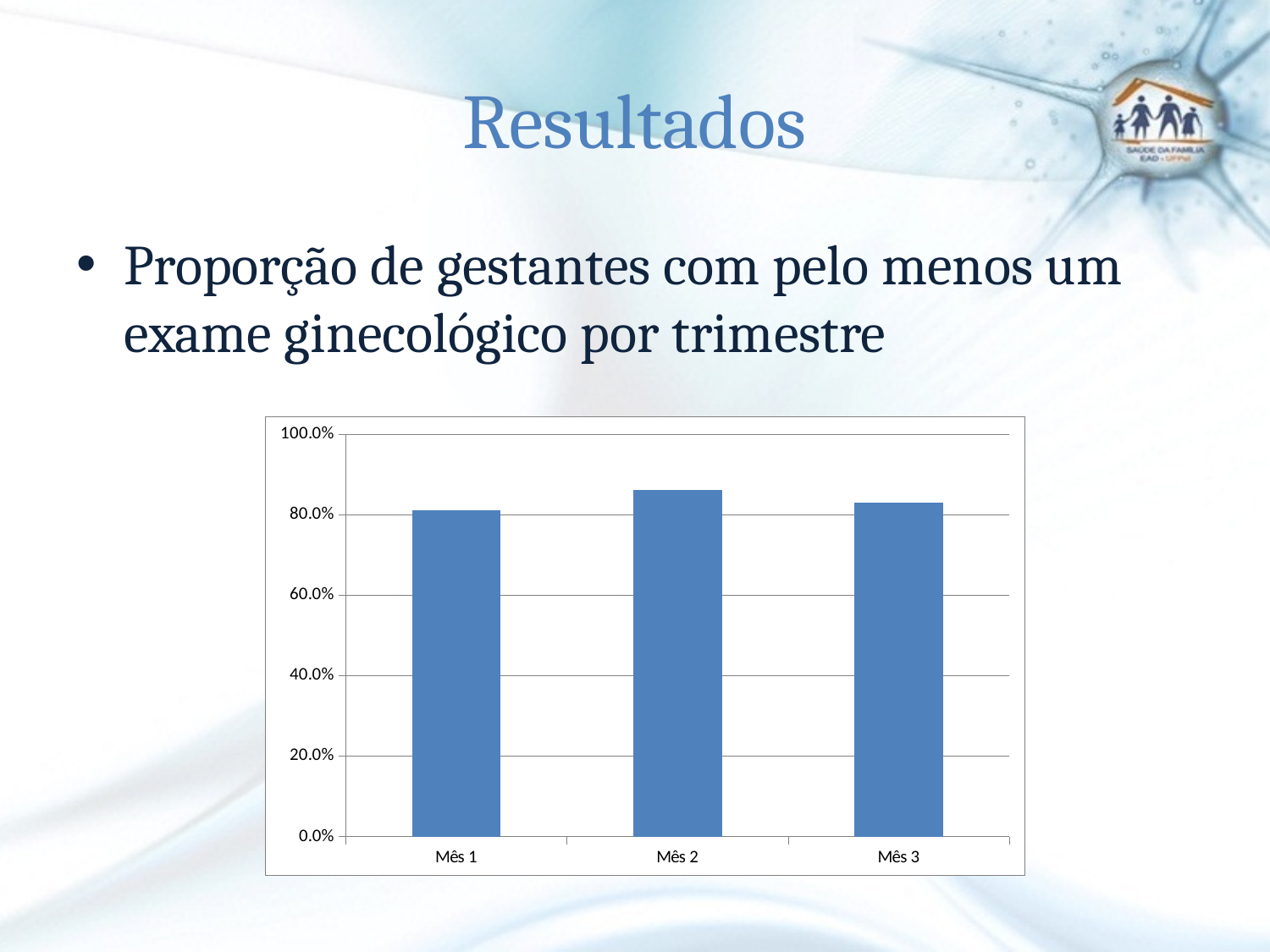
How many categories are shown on the x axis of the chart? 3 Which is larger, the value for Mês 2 or the value for Mês 3? Mês 2 What kind of chart is shown on the slide? bar chart Is the value for Mês 3 greater or less than 80.0%? greater Is the value for Mês 2 greater or less than 80.0%? greater Is the value for Mês 2 greater or less than 100.0%? less Which category has the highest value in the chart? Mês 2 What colour are the bars in the chart? blue Which is larger, the value for Mês 1 or the value for Mês 2? Mês 2 Does the value rise or fall from Mês 1 to Mês 2? rise